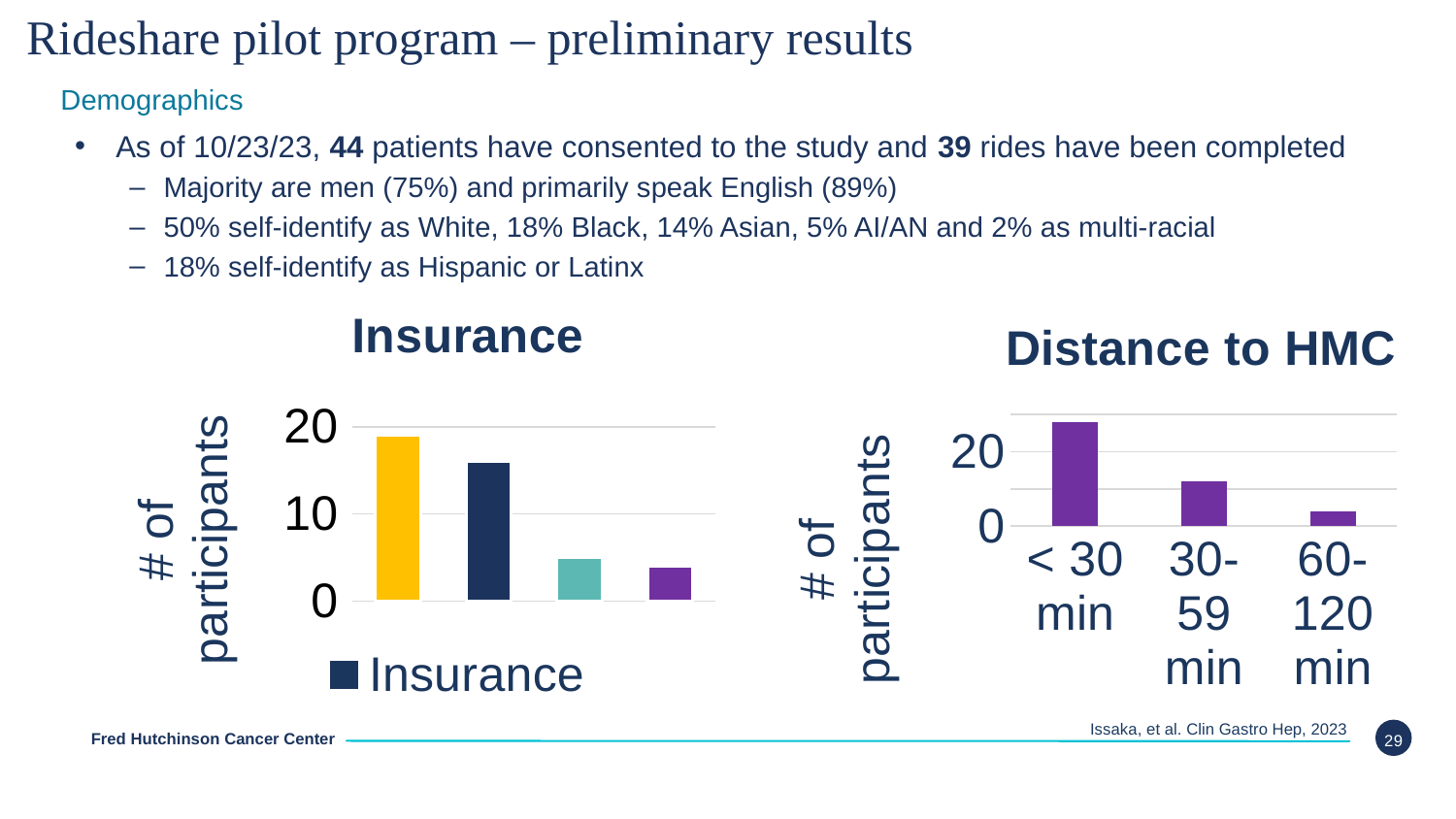
How many bars are plotted in the "Insurance" chart? 4 In the "Distance to HMC" chart, do the values rise or fall as distance increases along the x axis? fall In the "Distance to HMC" chart, is the value for < 30 min greater or less than 20? greater What is the y-axis label of the "Insurance" chart? # of participants In the "Distance to HMC" chart, how many distance categories are shown? 3 What kind of chart is the "Distance to HMC" chart? bar chart What kind of chart is the "Insurance" chart? bar chart In the "Distance to HMC" chart, is the value for 60-120 min greater or less than 20? less In the "Distance to HMC" chart, which category has the highest number of participants? < 30 min In the "Distance to HMC" chart, which category has the lowest number of participants? 60-120 min In the "Distance to HMC" chart, which has more participants: < 30 min or 30-59 min? < 30 min In the "Distance to HMC" chart, is the value for 30-59 min greater or less than 20? less